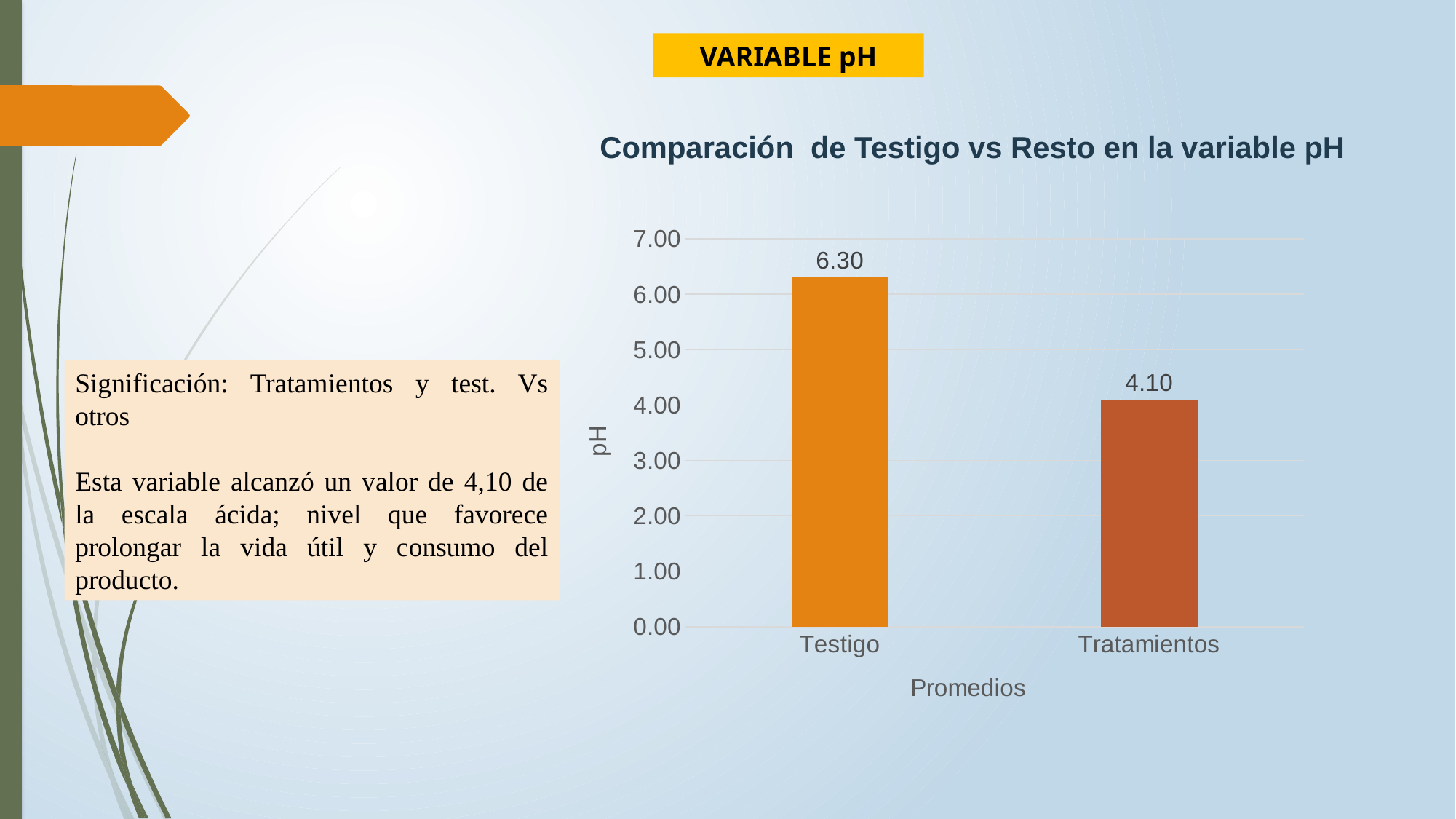
What is the pH value for Testigo? 6.30 Which category has the lowest pH value? Tratamientos Which has a larger pH value, Testigo or Tratamientos? Testigo Which category has the highest pH value? Testigo Is the pH value for Testigo greater or less than 6.00? greater What is the title of the chart? Comparación de Testigo vs Resto en la variable pH How many categories are shown on the x axis? 2 What is the pH value for Tratamientos? 4.10 What kind of chart is shown on the slide? bar chart Is the pH value for Tratamientos greater or less than 5.00? less What is the difference in pH between Testigo and Tratamientos? 2.20 What is the label of the x axis? Promedios